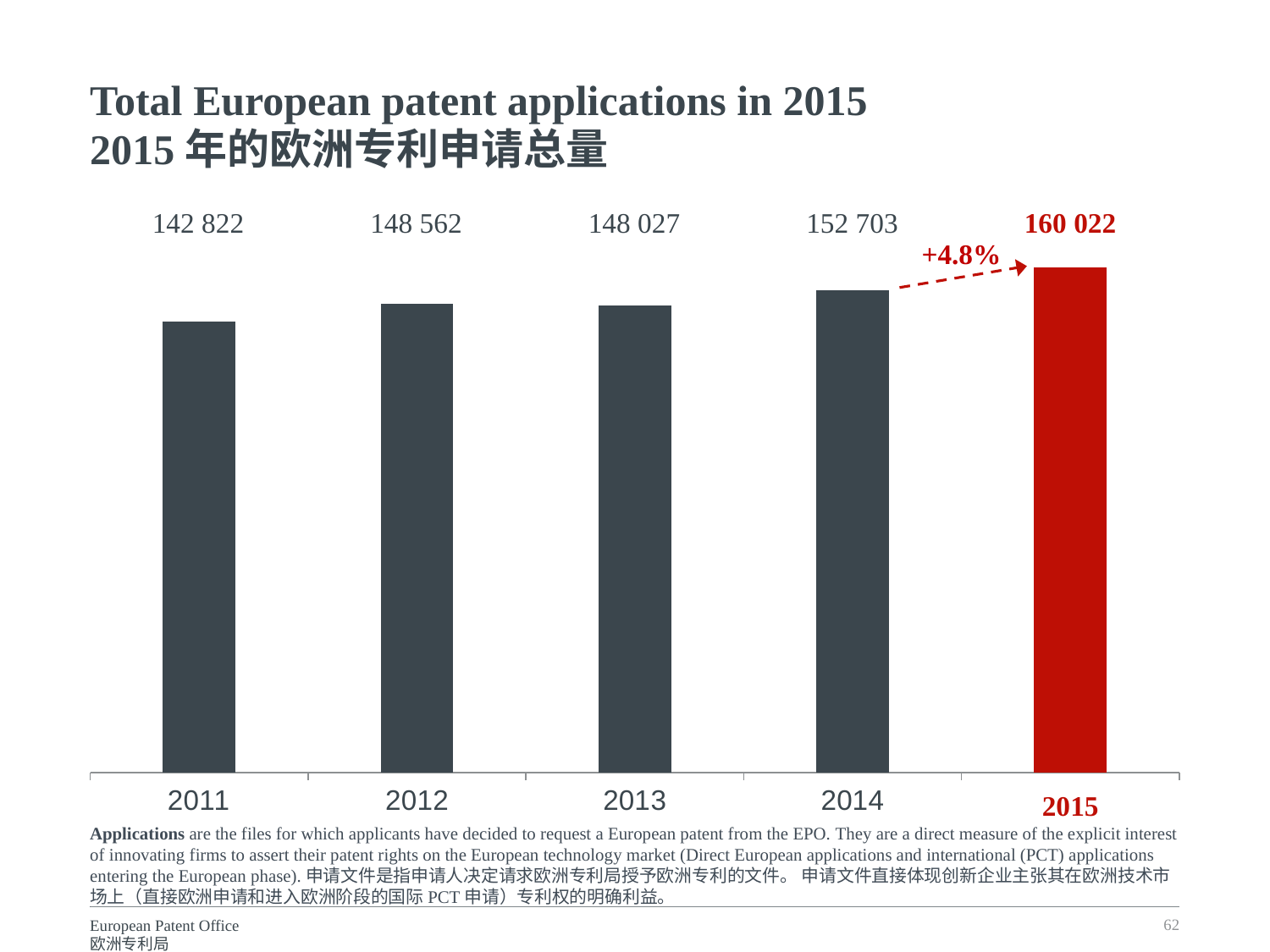
What is the difference between the values for 2015 and 2014? 7 319 What is the value for 2013? 148 027 What is the difference between the values for 2012 and 2011? 5 740 What percentage change is annotated between 2014 and 2015? +4.8% Which bar is coloured red rather than dark grey? 2015 What kind of chart is shown on the slide? Bar chart How many years are shown on the chart? 5 What is the value for 2015? 160 022 Which year has the lowest number of European patent applications? 2011 Which is larger, the value for 2014 or the value for 2013? 2014 Which year has the highest number of European patent applications? 2015 What is the value for 2011? 142 822